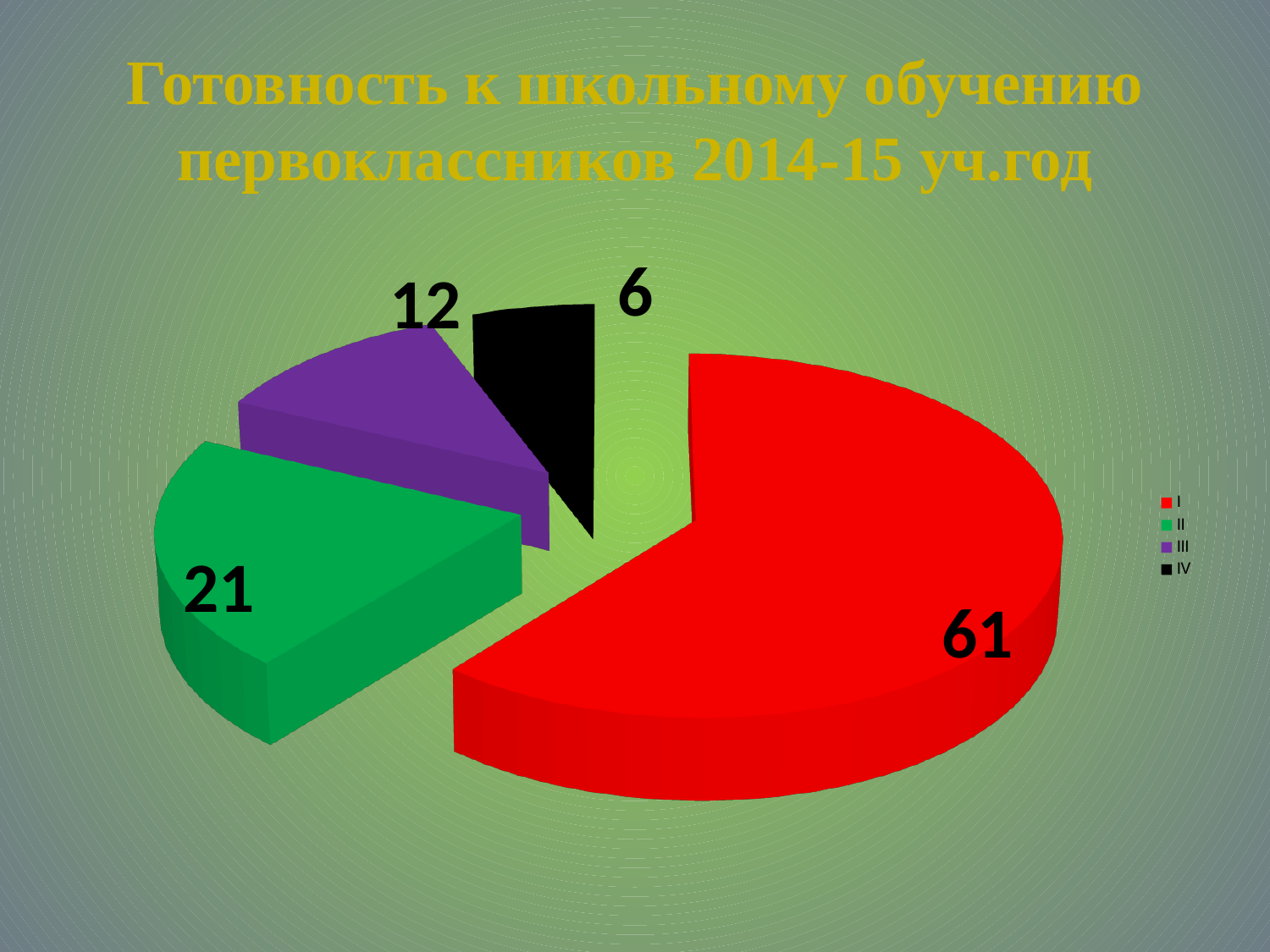
What share of the pie does category I represent? 61% Which category has the smallest slice? IV What is the value for category III? 12 What type of chart is shown on the slide? pie chart How many slices does the pie chart have? 4 What is the value for category I? 61 What colour is the slice for category II? green What is the value for category II? 21 Which is larger, the value for category III or category IV? III What is the value for category IV? 6 What is the difference between the values for category I and category II? 40 Which category has the largest slice? I